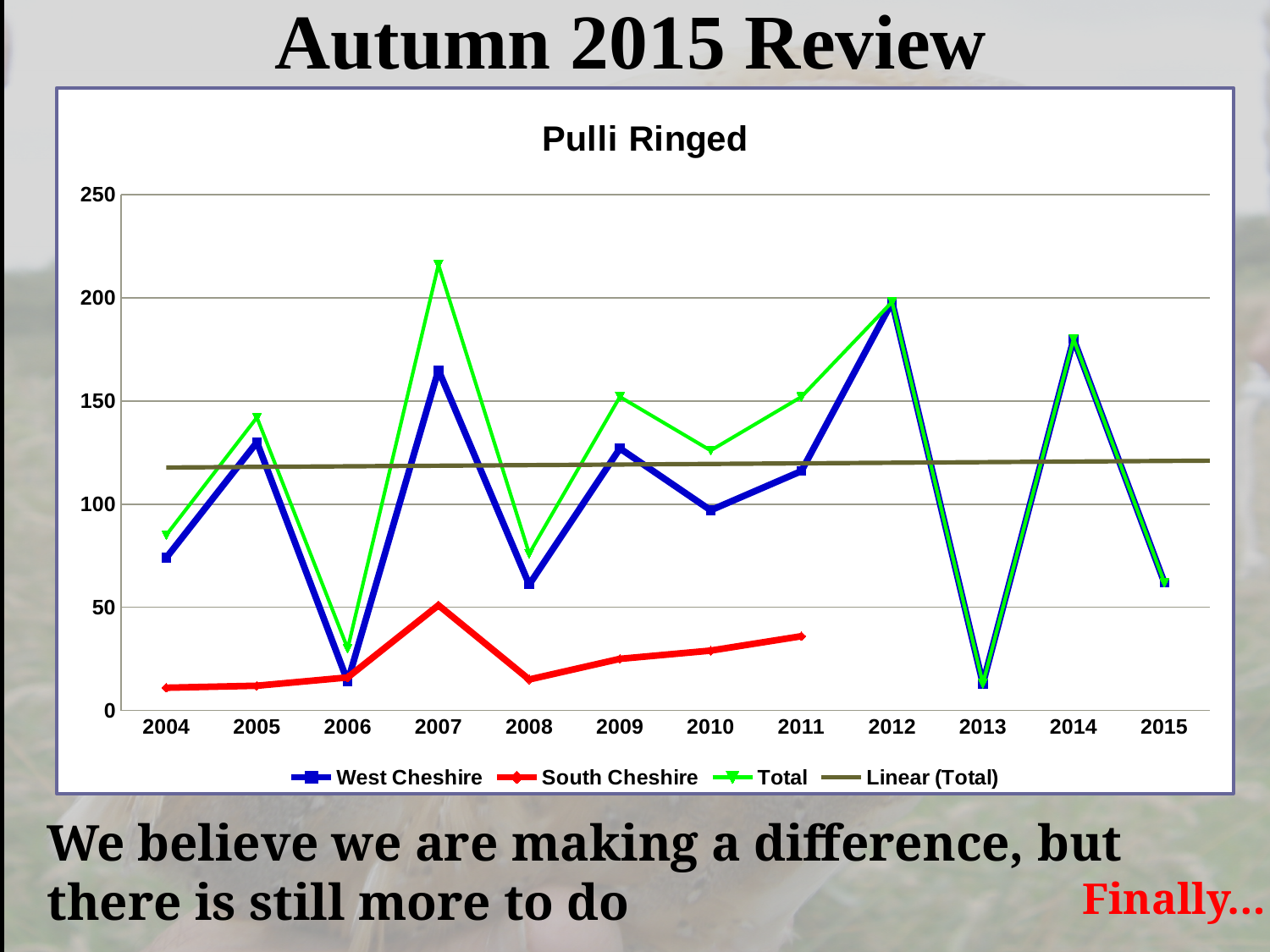
Is the value for Total in 2007 greater or less than 200? greater Is the value for West Cheshire in 2007 greater or less than 150? greater Which is larger, the Total value in 2007 or the Total value in 2012? 2007 In which year does the Total series reach its highest value? 2007 What is the title of the chart? Pulli Ringed How many years are shown on the x axis? 12 How many series does the legend list? 4 In which year does the Total series reach its lowest value? 2013 Is the value for South Cheshire in 2011 greater or less than 50? less In which year does the West Cheshire series reach its highest value? 2012 In which year does the South Cheshire series reach its highest value? 2007 What kind of chart is shown on the slide? Line chart